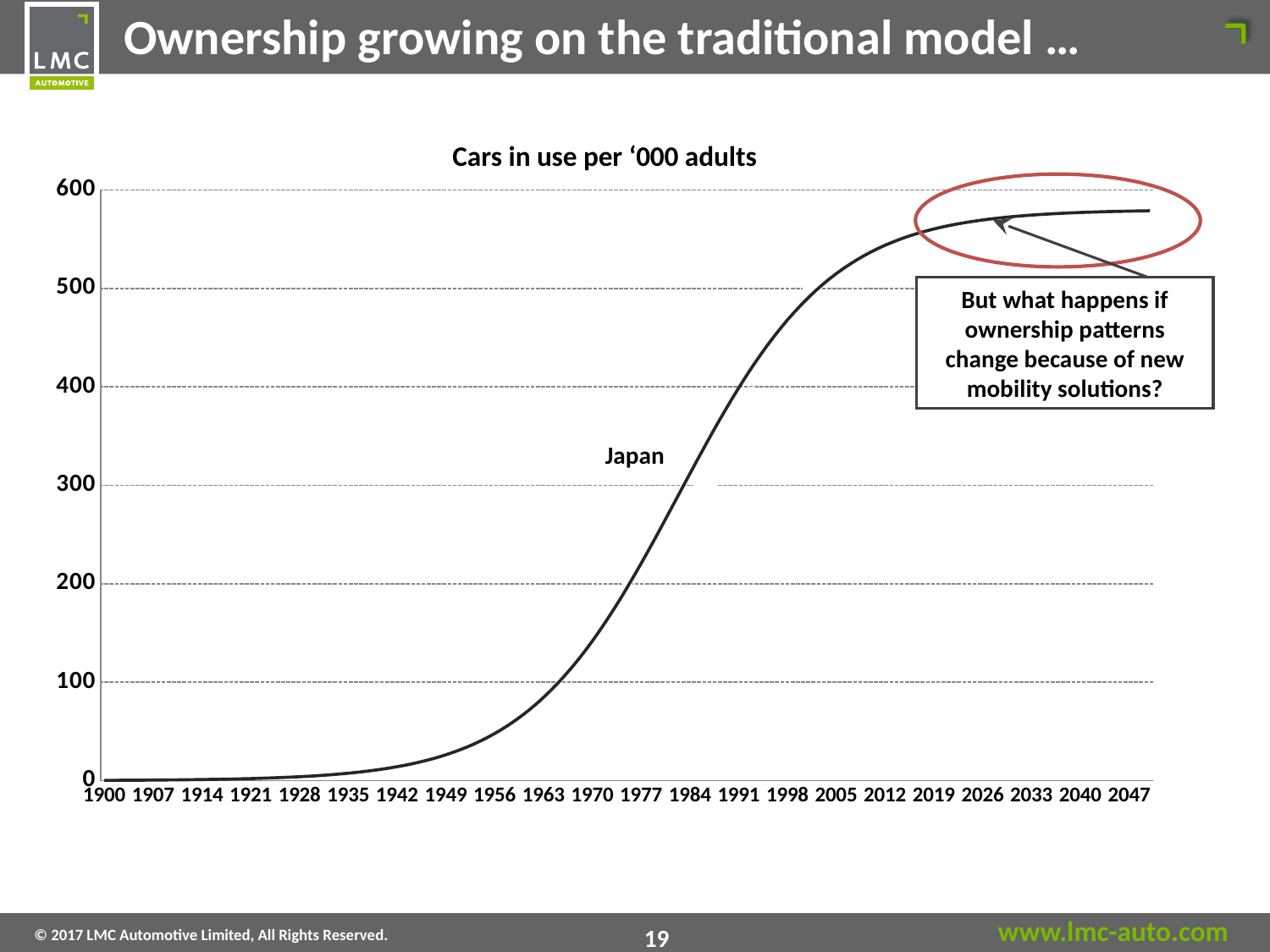
Is the value for Japan in 2047 greater or less than 600? less Which country does the plotted line represent? Japan Which year has the higher value for Japan, 1963 or 2005? 2005 What is the title of the chart? Cars in use per '000 adults Is the value for Japan in 1970 greater or less than 200? less What kind of chart is shown on the slide? line chart How many year labels are shown on the x axis? 22 Is the value for Japan in 1977 greater or less than 200? greater Do the values for Japan rise or fall from 1900 to 2047? rise